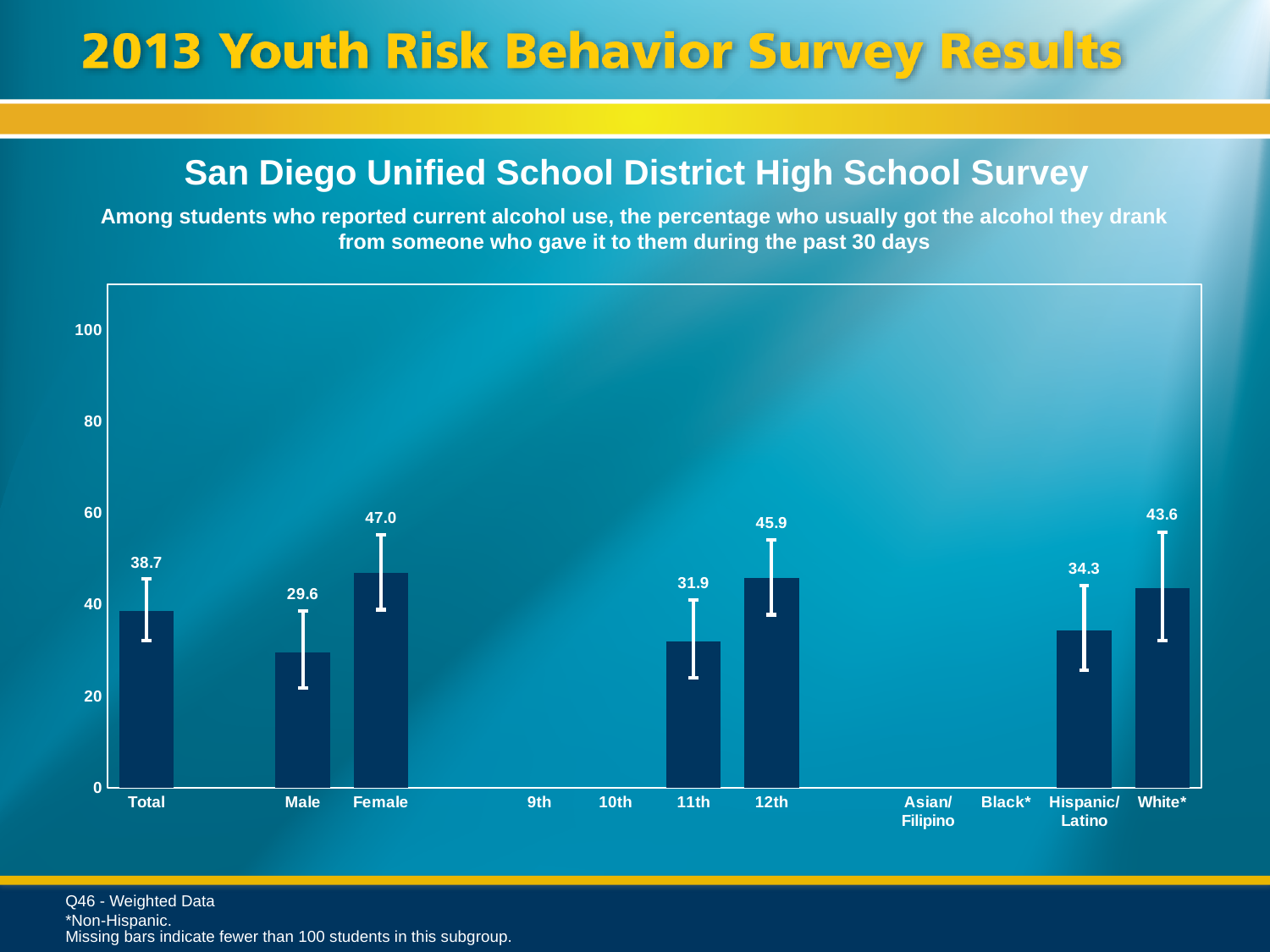
What kind of chart is shown? Bar chart Which categories on the x axis have no bar shown? 9th, 10th, Asian/Filipino, Black* What is the difference between the Female and Male values? 17.4 Which category has the highest value? Female Is the value for White* greater or less than 40? greater What is the value for Hispanic/Latino? 34.3 What is the value for 12th grade? 45.9 What is the value for Female? 47.0 Which is larger, the value for 11th grade or 12th grade? 12th How many categories have bars plotted? 7 Which category has the lowest value among those with bars? Male What is the value for Total? 38.7